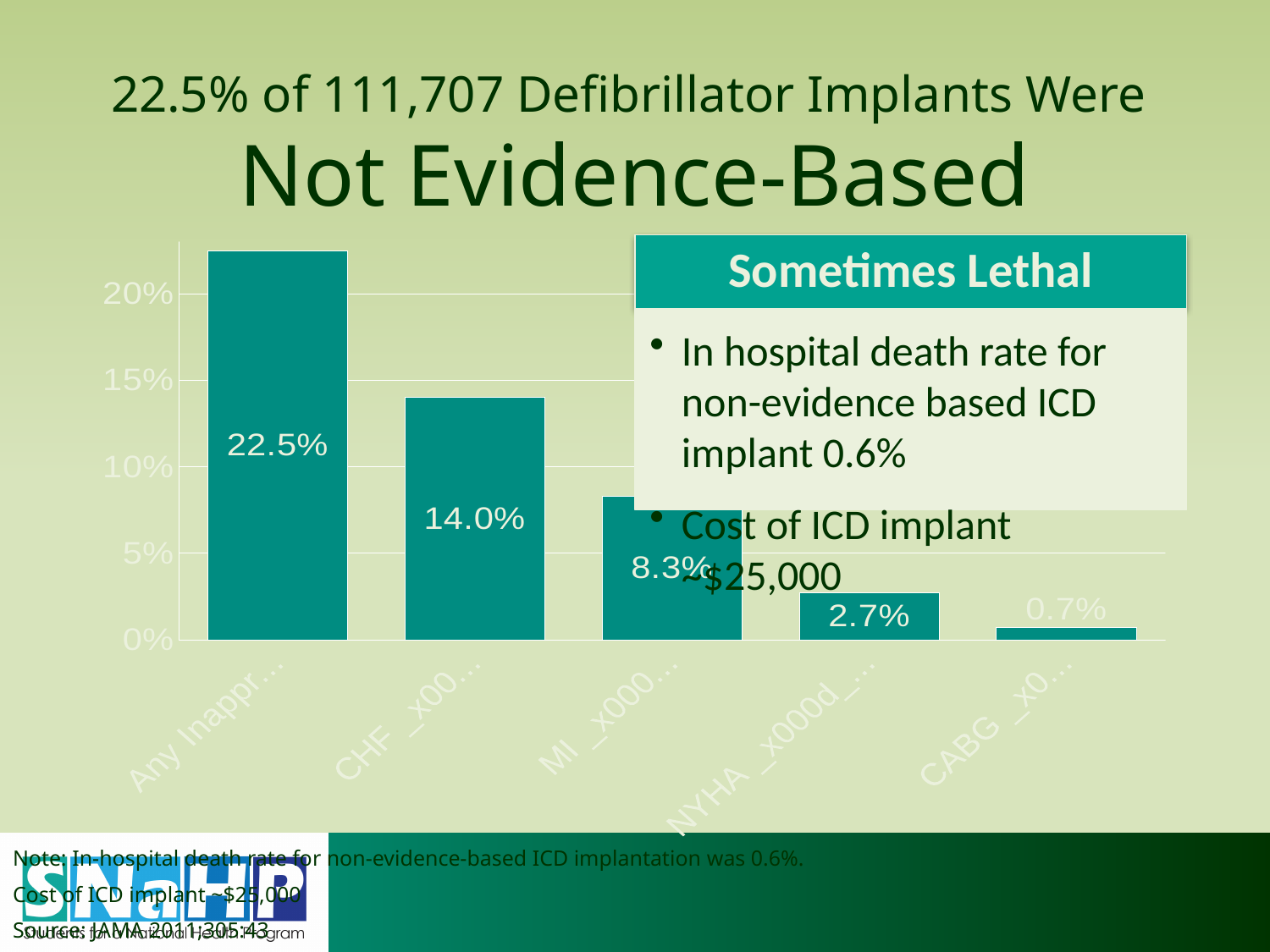
Which category has the lowest value in the chart? CABG What value is shown for the CHF bar? 14.0% What value is shown for the MI bar? 8.3% Which is larger, the value for MI or the value for NYHA? MI What kind of chart is shown on the slide? Bar chart Which category has the highest value in the chart? Any Inappr... (the first bar) What is the difference between the CHF bar and the MI bar? 5.7% What is the difference between the first bar (22.5%) and the CHF bar? 8.5% How many bars are plotted in the chart? 5 Do the bar values rise or fall from left to right across the chart? Fall What value is shown for the NYHA bar? 2.7% What value is shown for the CABG bar? 0.7%